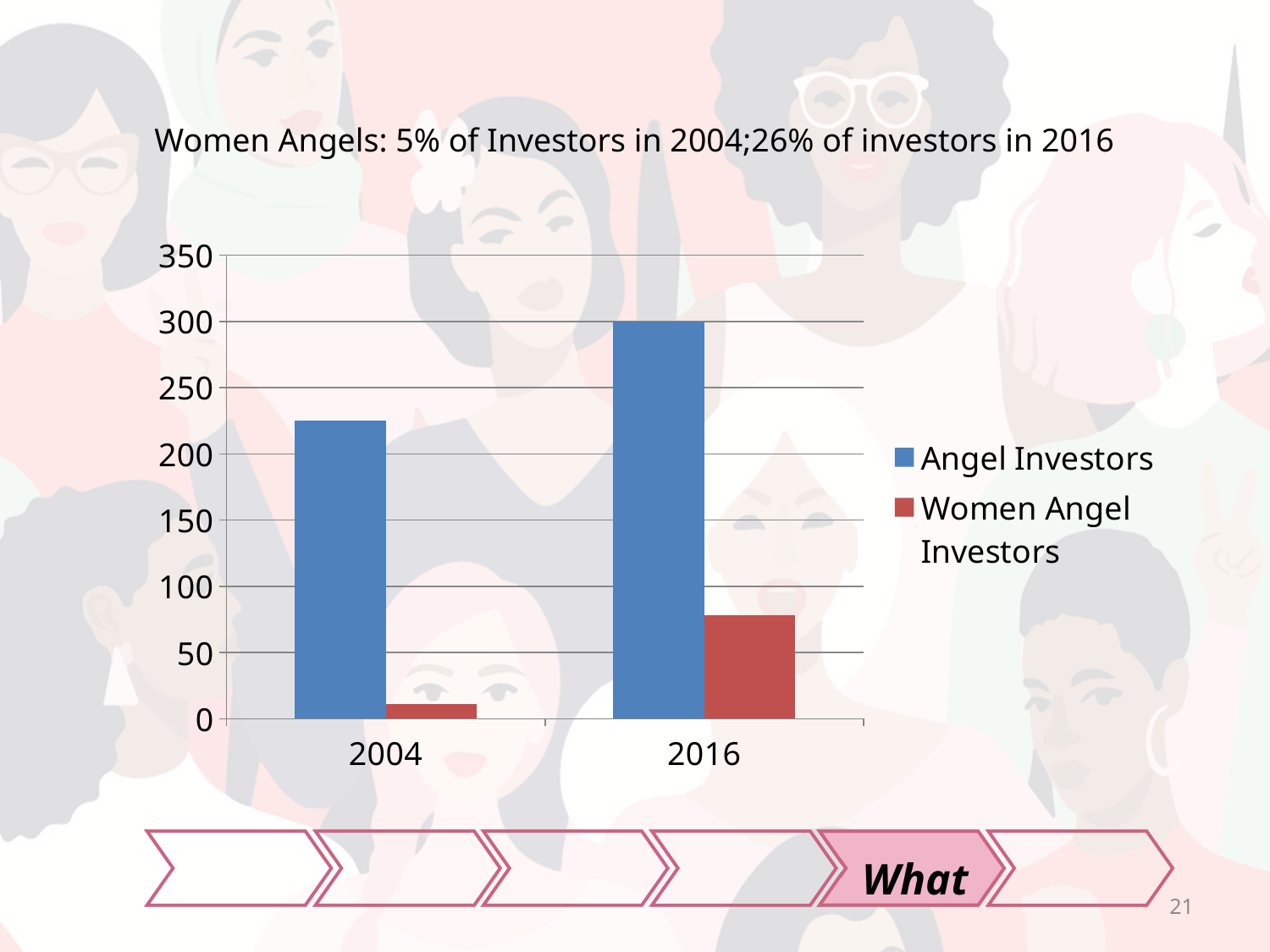
Is the value for Angel Investors in 2004 greater or less than 250? less Do the Women Angel Investors values rise or fall from 2004 to 2016? rise In which year is the Angel Investors value highest? 2016 Is the value for Women Angel Investors in 2004 greater or less than 50? less What kind of chart is shown on the slide? bar chart Is the value for Angel Investors in 2004 greater or less than 200? greater How many series does the legend list? 2 How many years are shown on the x axis? 2 Which year has the higher value for Women Angel Investors, 2004 or 2016? 2016 What is the title of the chart? Women Angels: 5% of Investors in 2004;26% of investors in 2016 What is the value for Angel Investors in 2016? 300